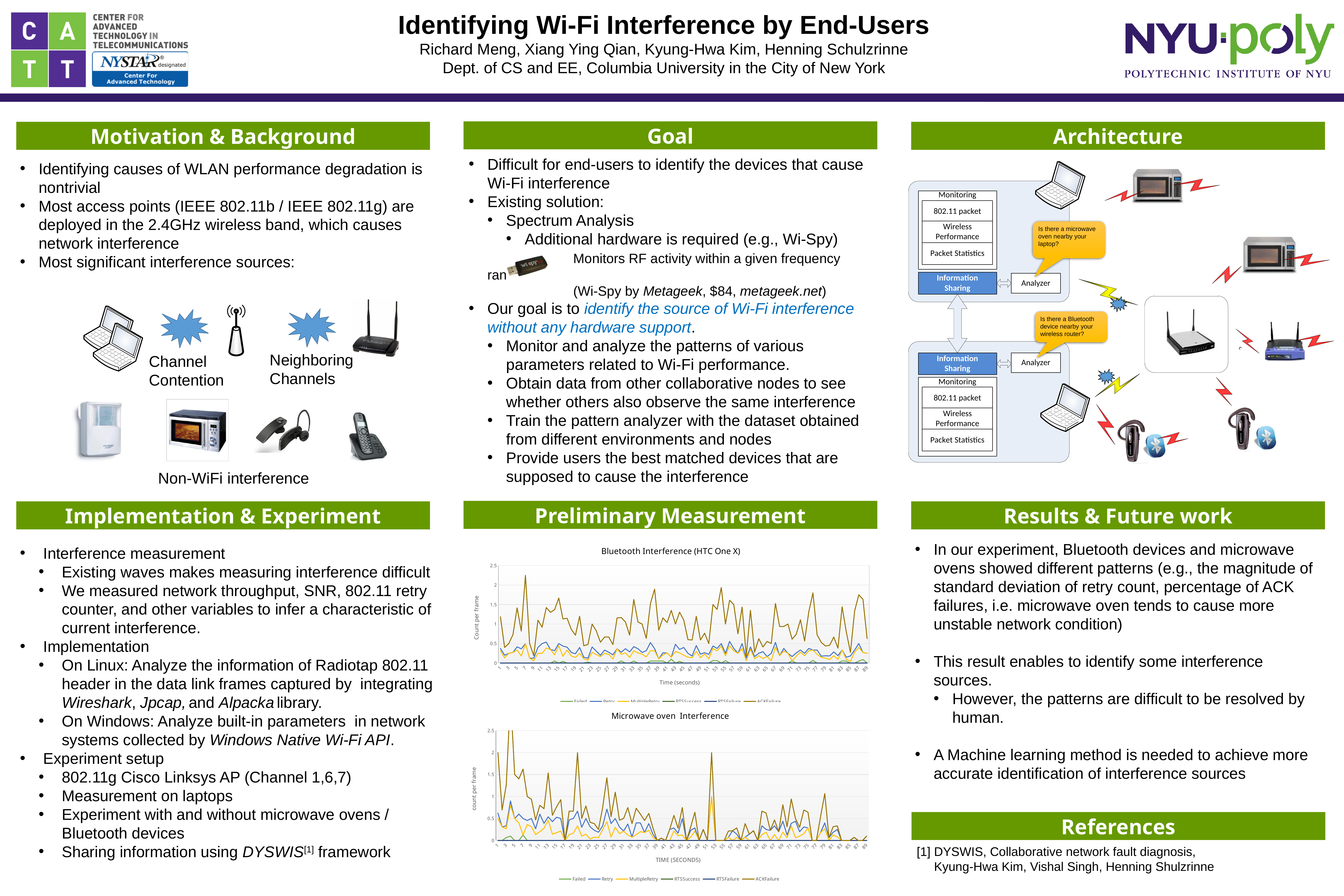
In the "Bluetooth Interference (HTC One X)" chart, which series reaches the highest values? ACKFailure What is the label of the y axis of the "Bluetooth Interference (HTC One X)" chart? Count per frame How many series does the legend of the "Bluetooth Interference (HTC One X)" chart list? 6 In the "Microwave oven Interference" chart, which series reaches the highest values? ACKFailure In the "Microwave oven Interference" chart, is the highest peak of the ACKFailure series greater or less than 2? greater What kind of chart is the "Microwave oven Interference" chart? line chart How many series does the legend of the "Microwave oven Interference" chart list? 6 In the "Bluetooth Interference (HTC One X)" chart, is the highest peak of the ACKFailure series greater or less than 2? greater In the "Microwave oven Interference" chart, does the Failed series ever rise above 0.5? No What is the label of the x axis of the "Microwave oven Interference" chart? TIME (SECONDS) What kind of chart is the "Bluetooth Interference (HTC One X)" chart? line chart